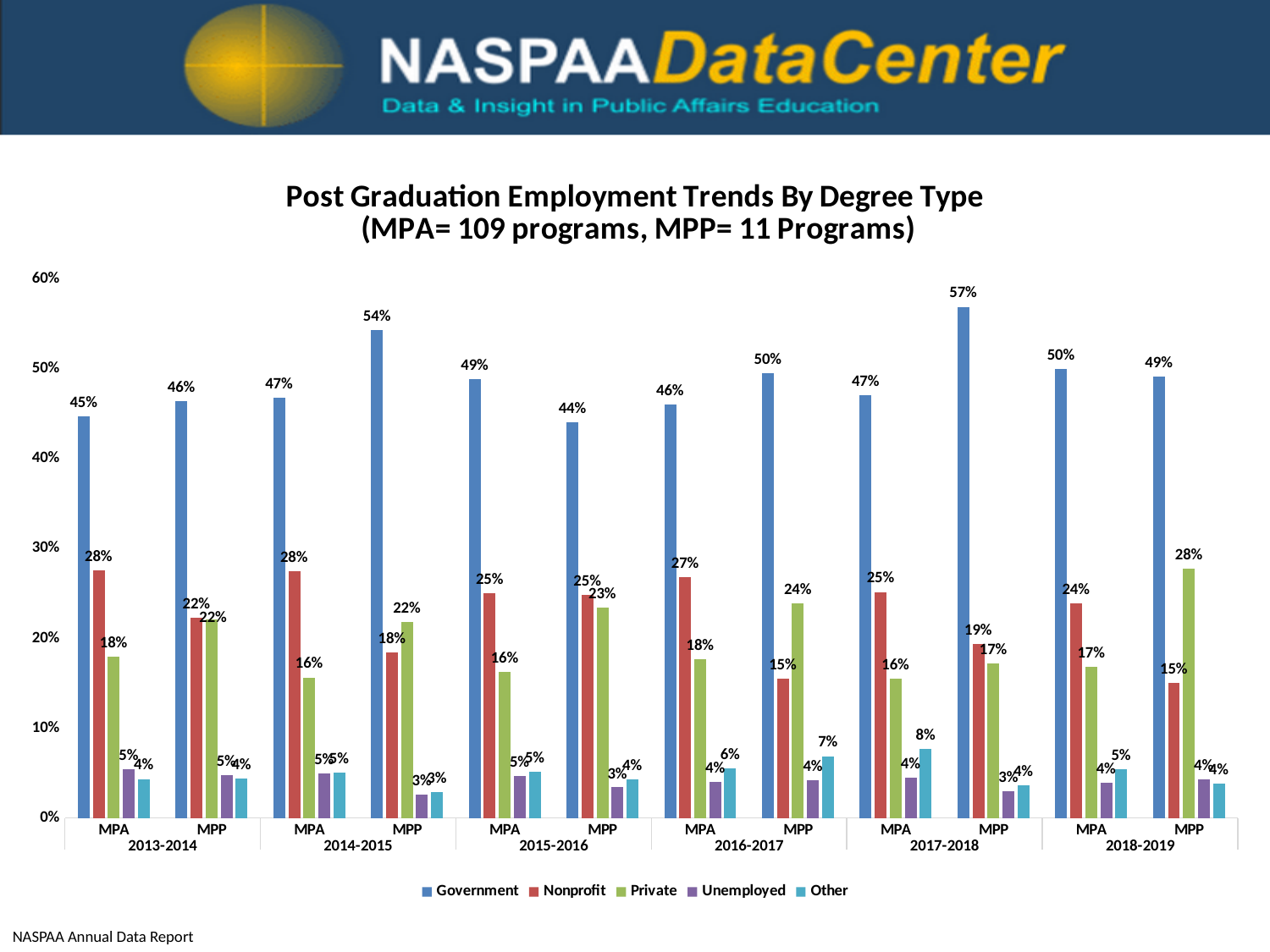
How many programs does the chart title say are included for MPP? 11 Which category group has the highest Government value? MPP 2017-2018 What is the Private value for MPP in 2018-2019? 28% What is the Government value for MPP in 2017-2018? 57% Which is larger for MPP in 2016-2017: Nonprofit or Private? Private What is the difference between the Government values for MPP and MPA in 2014-2015? 7% Which category group has the lowest Government value? MPP 2015-2016 What is the Other value for MPA in 2017-2018? 8% What kind of chart is shown on the slide? Bar chart What is the Nonprofit value for MPA in 2013-2014? 28% Is the Government value for MPA in 2015-2016 greater or less than 40%? greater How many series does the legend list? 5